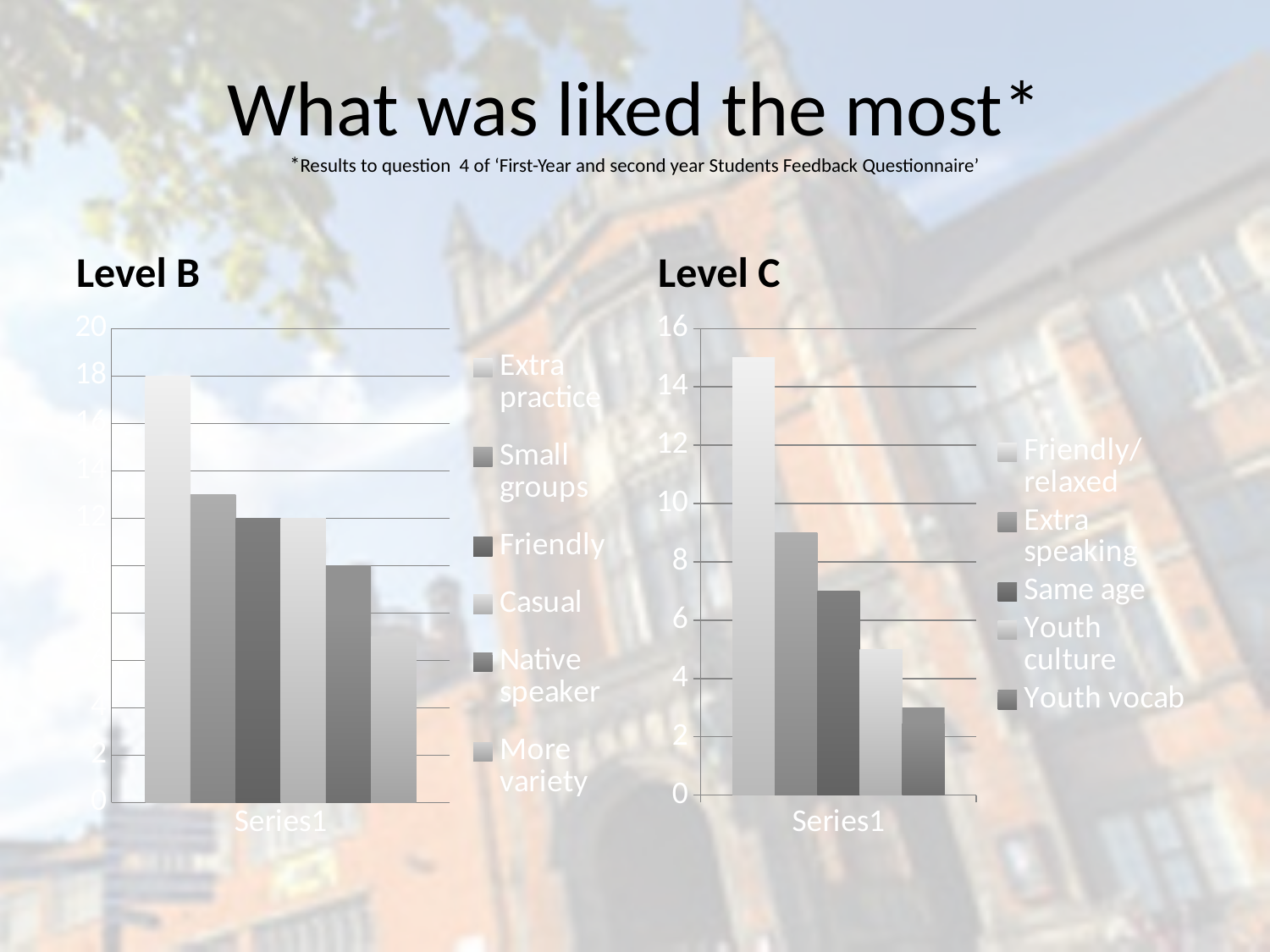
In the Level C chart, is the value for Friendly/relaxed greater or less than 14? greater In the Level B chart, is the value for Small groups greater or less than 12? greater How many categories does the legend of the Level B chart list? 6 What kind of chart is the Level B chart? bar chart In the Level C chart, which category has the highest value? Friendly/relaxed In the Level C chart, which category has the lowest value? Youth vocab In the Level B chart, what is the value for Extra practice? 18 How many categories does the legend of the Level C chart list? 5 In the Level C chart, which is larger, Extra speaking or Youth culture? Extra speaking In the Level B chart, is the value for More variety greater or less than 8? less In the Level B chart, which category has the highest value? Extra practice In the Level B chart, which category has the lowest value? More variety